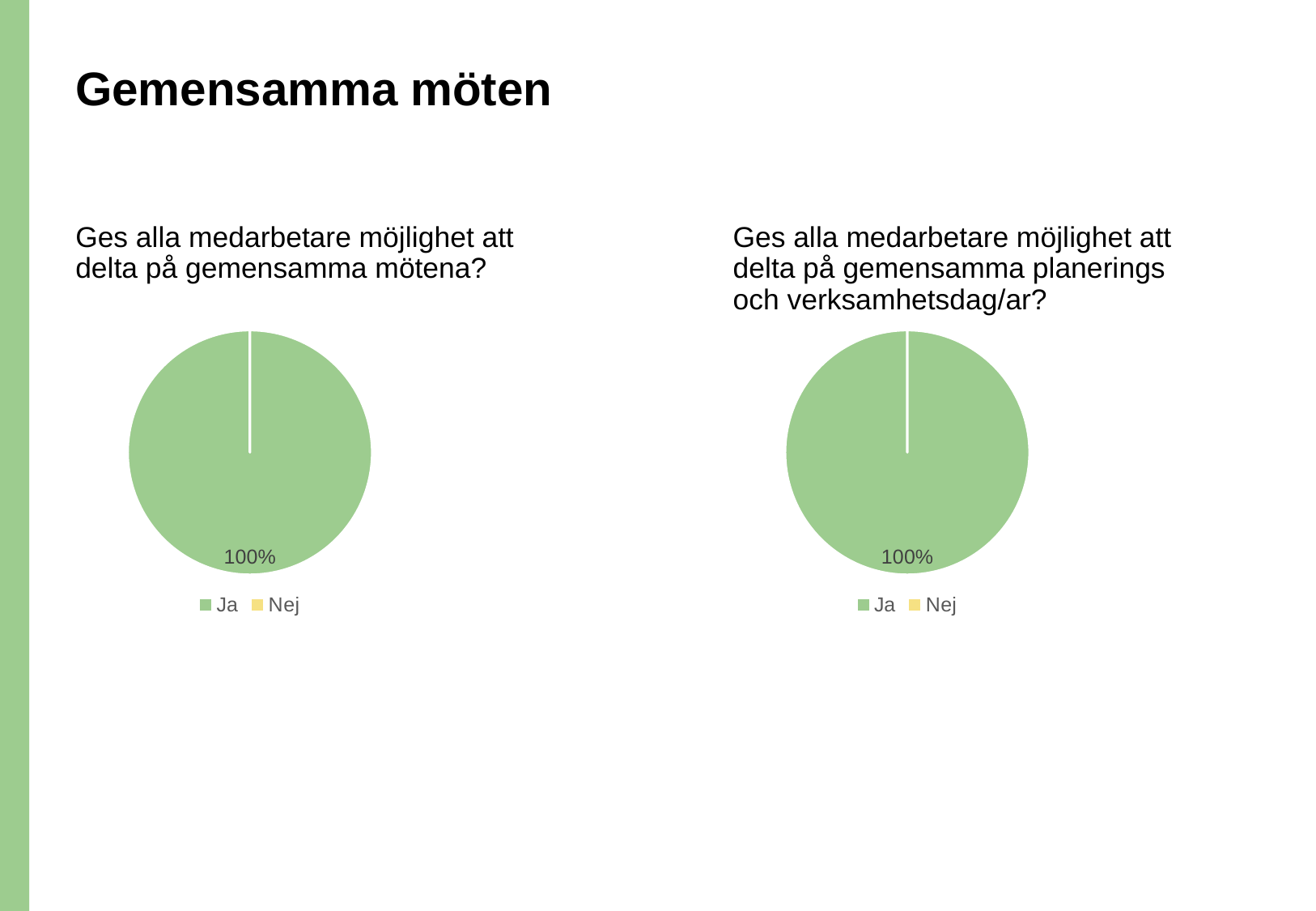
In the left chart, which is larger, the share for "Ja" or the share for "Nej"? Ja What kind of chart is the left chart on the slide? Pie chart In the right chart ("Ges alla medarbetare möjlighet att delta på gemensamma planerings och verksamhetsdag/ar?"), what share of the pie is "Ja"? 100% In the left chart, which category has the largest share? Ja What kind of chart is the right chart on the slide? Pie chart In the left chart ("Ges alla medarbetare möjlighet att delta på gemensamma mötena?"), what share of the pie is "Ja"? 100% What colour represents "Ja" in the right chart? Green In the right chart, which category has the largest share? Ja What are the legend entries of the left chart? Ja, Nej How many entries does the legend of the right chart list? 2 In the right chart, which is larger, the share for "Ja" or the share for "Nej"? Ja How many entries does the legend of the left chart list? 2